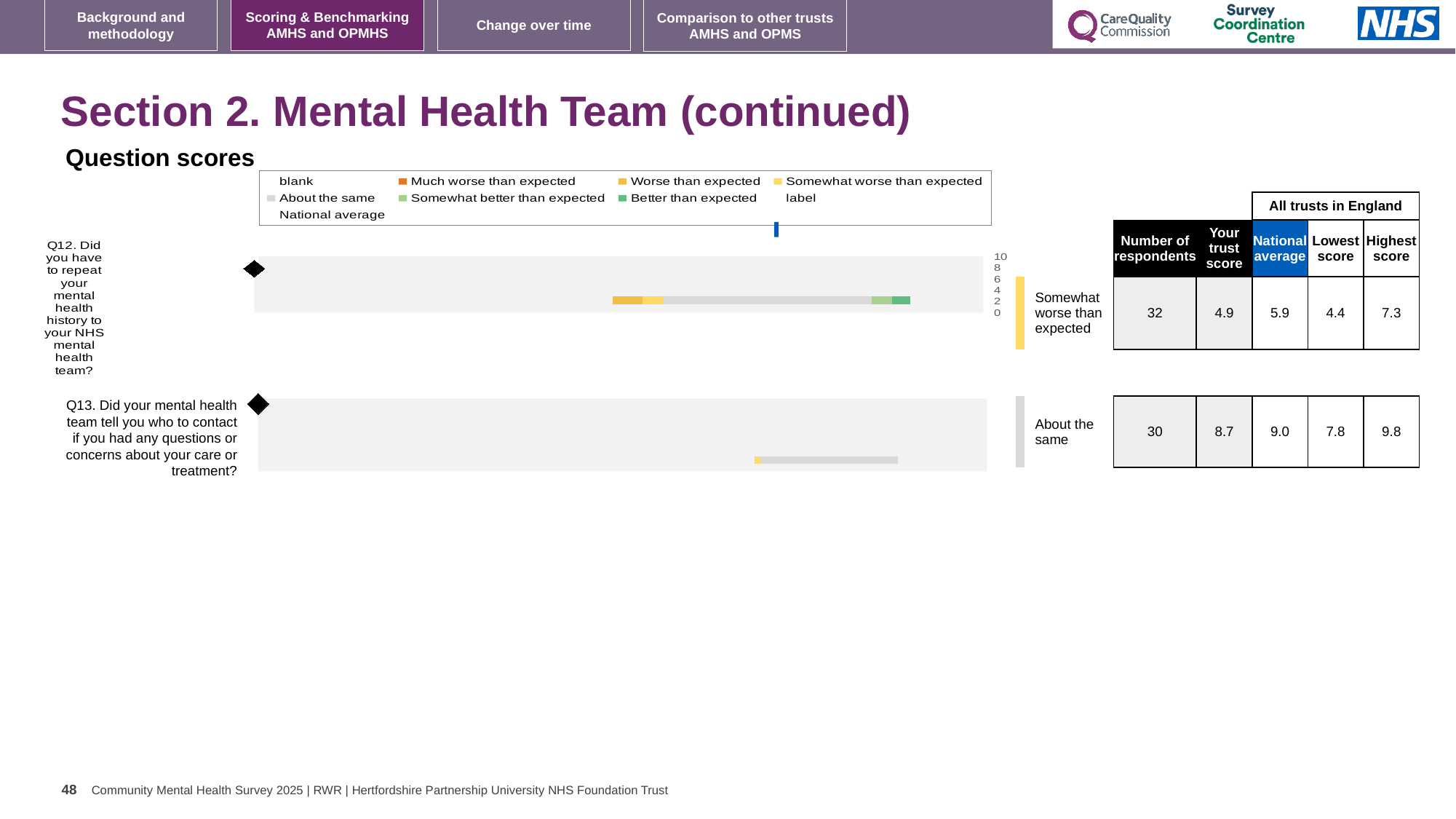
For Q12, what is the number of respondents shown in the table? 32 What benchmark category is shown for Q13? About the same For Q13, what is the trust's score? 8.7 What kind of chart is used to show the question scores on this slide? bar chart What benchmark category is shown for Q12? Somewhat worse than expected For Q12, what is the national average score? 5.9 For Q12, what is the highest score among all trusts in England? 7.3 For Q13, what is the lowest score among all trusts in England? 7.8 For Q13, which is larger: the trust's score or the national average? the national average For Q12, what is the trust's score? 4.9 For Q12, what is the difference between the highest score and the lowest score among all trusts in England? 2.9 How many questions (Q12 and Q13) are plotted on the slide? 2